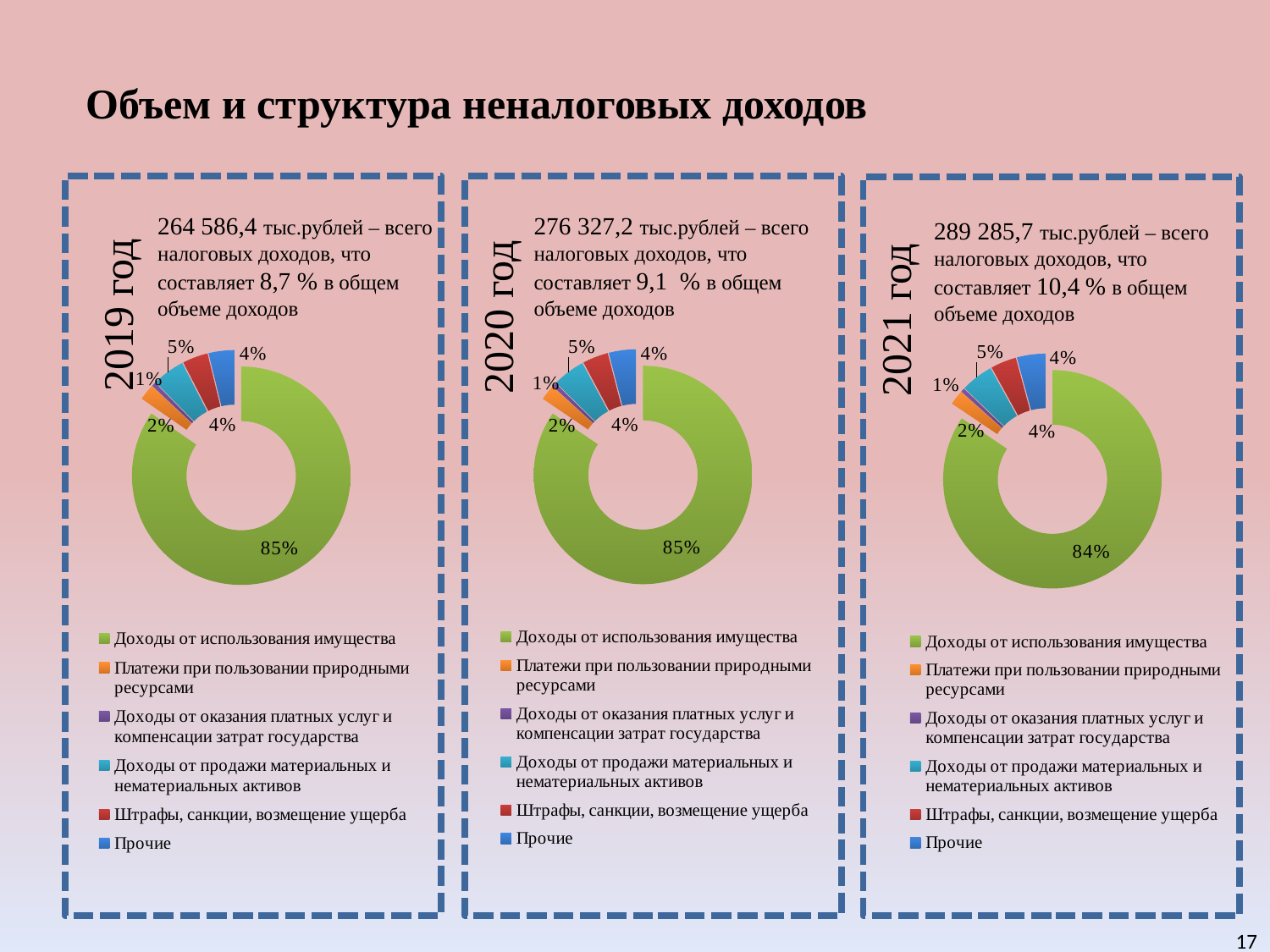
In the 2020 год chart, what is the difference in percentage points between Доходы от использования имущества and Штрафы, санкции, возмещение ущерба? 81 What kind of chart is used for 2021 год? Doughnut (pie) chart In the 2019 год chart, what share does Доходы от оказания платных услуг и компенсации затрат государства have? 1% In the 2021 год chart, what share does Доходы от использования имущества have? 84% How many categories does the legend of the 2019 год chart list? 6 In the 2020 год chart, what share does Штрафы, санкции, возмещение ущерба have? 4% In the 2021 год chart, which is larger: Штрафы, санкции, возмещение ущерба or Платежи при пользовании природными ресурсами? Штрафы, санкции, возмещение ущерба In the 2019 год chart, which category has the smallest share? Доходы от оказания платных услуг и компенсации затрат государства What is the title of the slide containing the three charts? Объем и структура неналоговых доходов In the 2020 год chart, which category has the largest share? Доходы от использования имущества